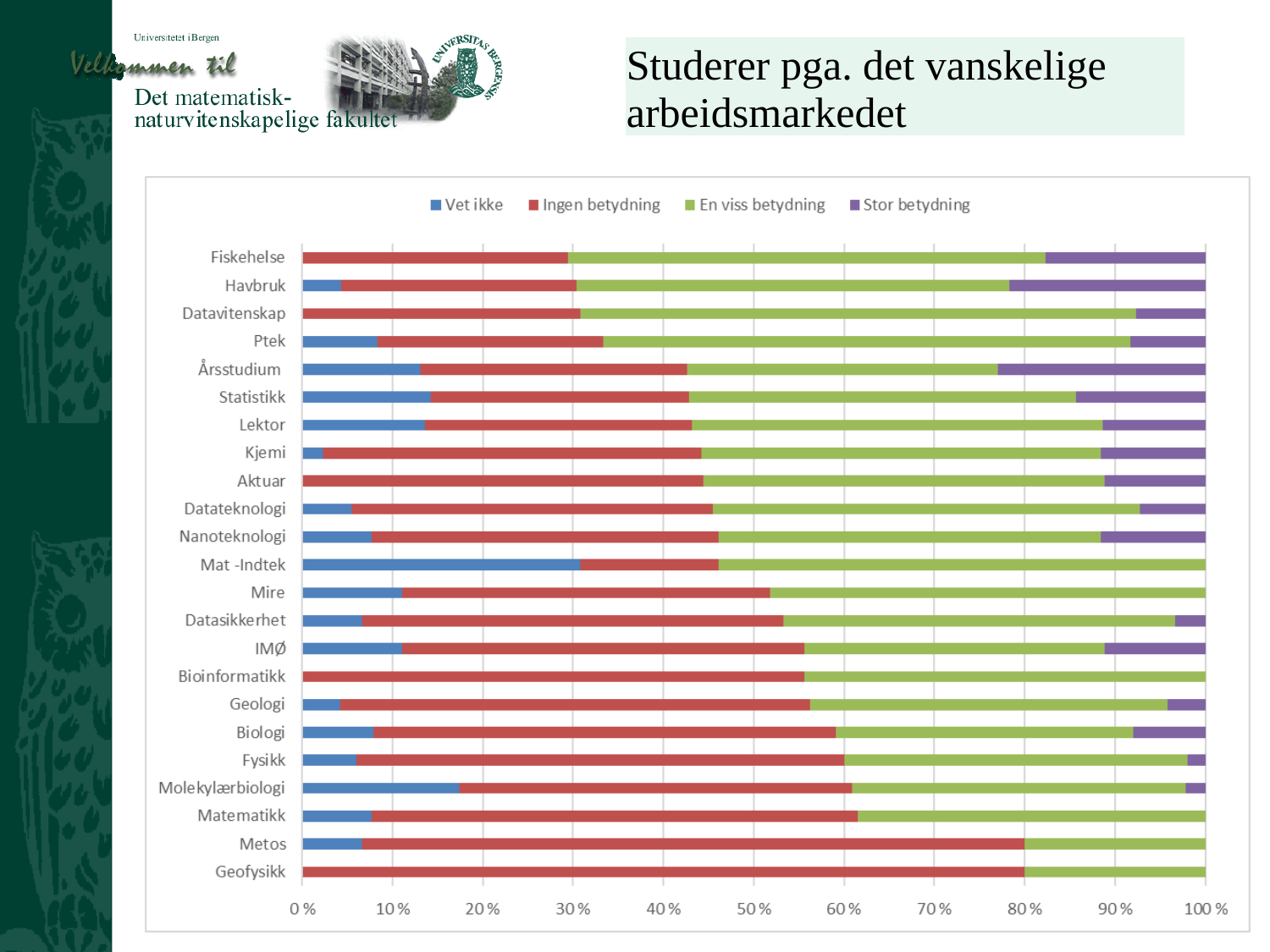
Which category is listed at the bottom of the chart? Geofysikk Is the 'Ingen betydning' share for Fiskehelse greater or less than 40%? less What are the four legend entries of the chart? Vet ikke, Ingen betydning, En viss betydning, Stor betydning Which category has the largest 'Vet ikke' share? Mat -Indtek How many categories (study programmes) are plotted on the chart? 23 What does each stacked bar total on the x axis? 100% What is the title of the slide above the chart? Studerer pga. det vanskelige arbeidsmarkedet Which has the larger 'Vet ikke' share, Mat -Indtek or Molekylærbiologi? Mat -Indtek Is the 'Vet ikke' share for Molekylærbiologi greater or less than 10%? greater How many series does the legend list? 4 Is the 'Vet ikke' share for Mat -Indtek greater or less than 20%? greater What kind of chart is shown on the slide? Stacked bar chart